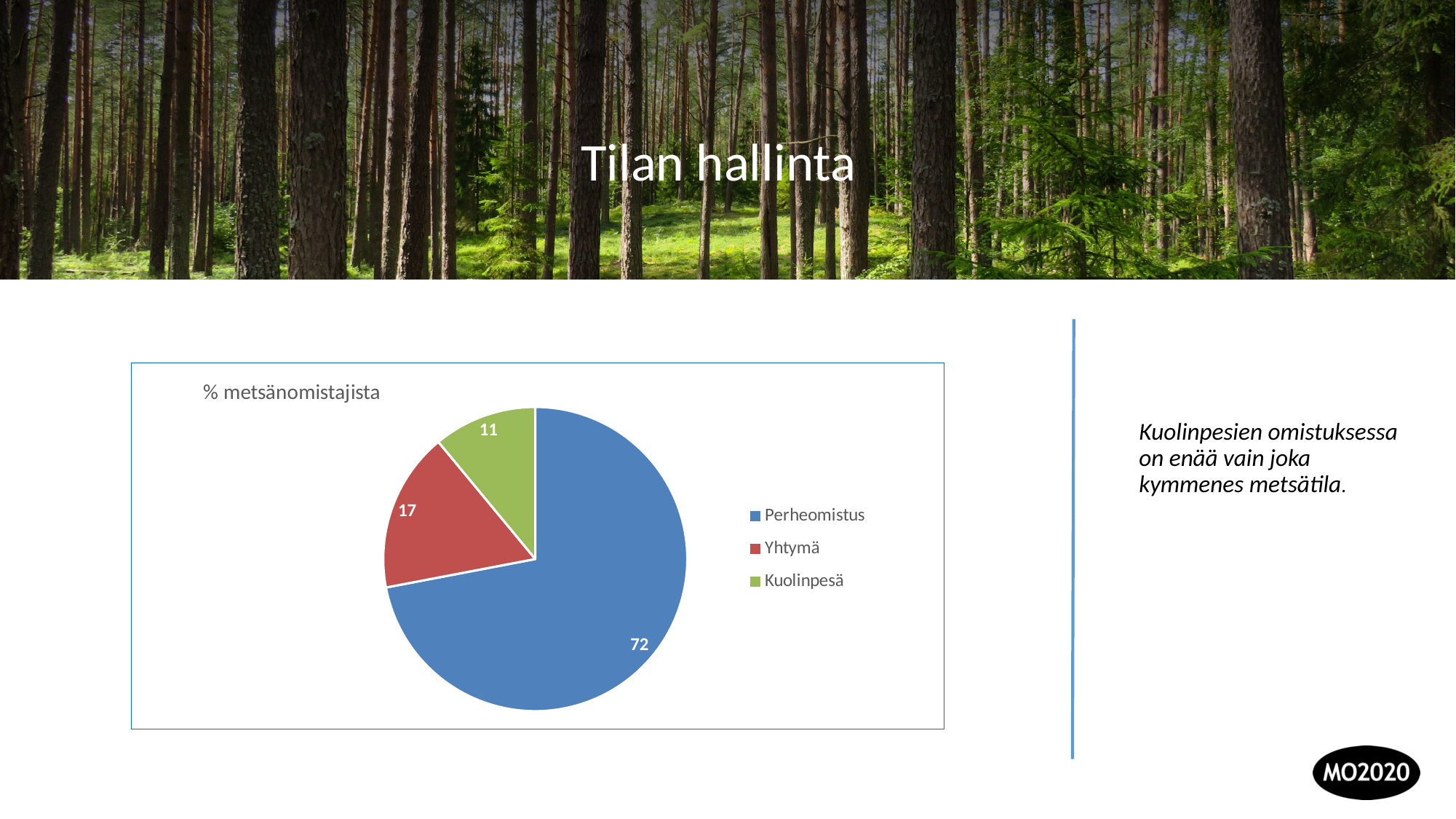
How many slices does the pie chart have? 3 Which category has the smallest slice? Kuolinpesä What is the difference between the values for Perheomistus and Yhtymä? 55 What is the difference between the values for Yhtymä and Kuolinpesä? 6 What is the value for Perheomistus? 72 What is the title of the chart? % metsänomistajista What colour is the Kuolinpesä slice? green What is the value for Kuolinpesä? 11 Which category has the largest slice? Perheomistus What is the value for Yhtymä? 17 Which is larger, Yhtymä or Kuolinpesä? Yhtymä What kind of chart is shown on the slide? pie chart